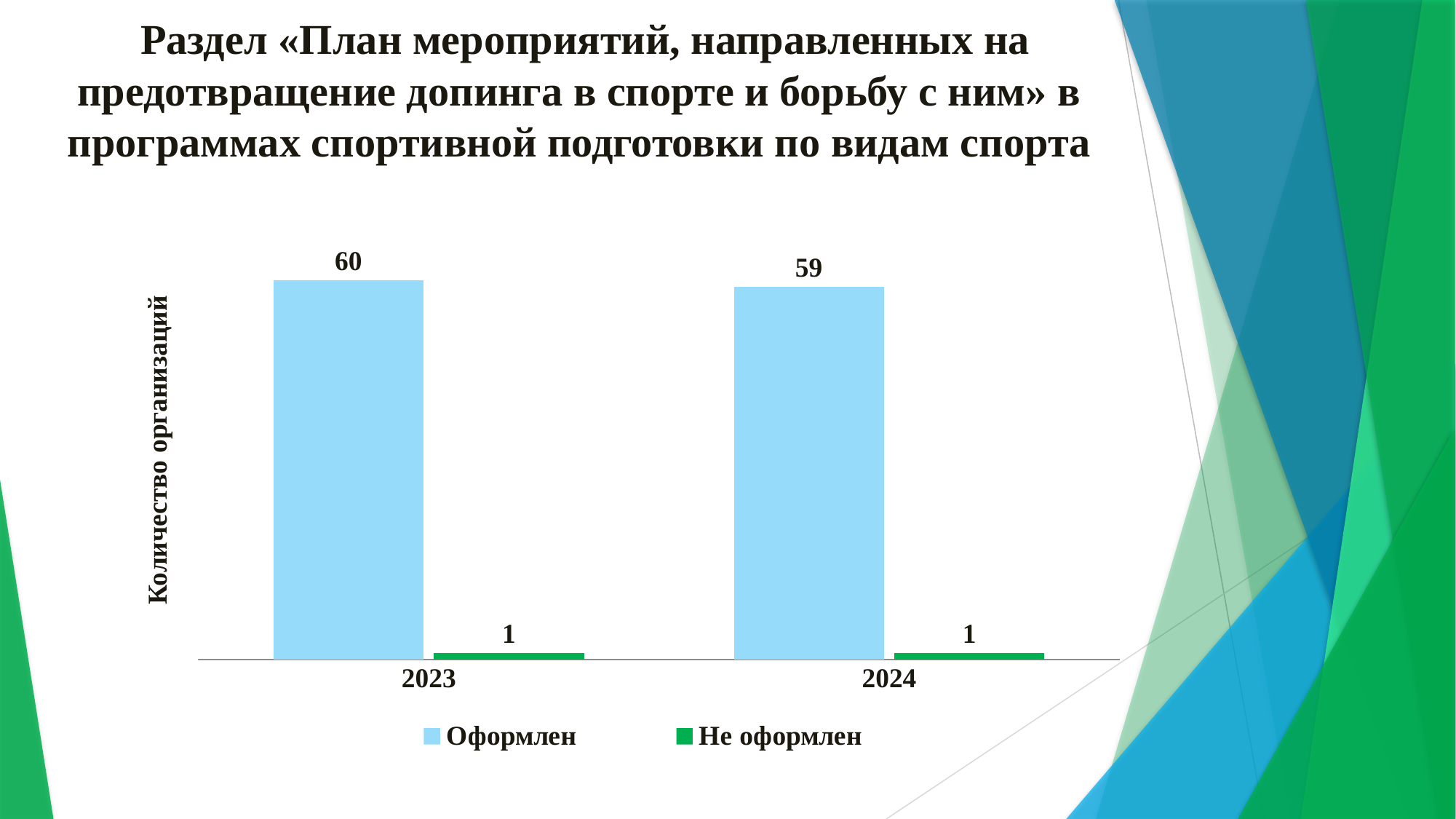
How many series does the legend list? 2 What is the label of the vertical axis? Количество организаций What is the value for "Не оформлен" in 2024? 1 Does the "Оформлен" series rise or fall from 2023 to 2024? Fall What kind of chart is shown on the slide? Bar chart What is the value for "Не оформлен" in 2023? 1 How many categories are shown on the x axis? 2 What is the difference between "Оформлен" and "Не оформлен" in 2023? 59 What is the difference between the "Оформлен" values for 2023 and 2024? 1 What is the value for "Оформлен" in 2024? 59 What is the value for "Оформлен" in 2023? 60 Which is larger in 2024, "Оформлен" or "Не оформлен"? Оформлен